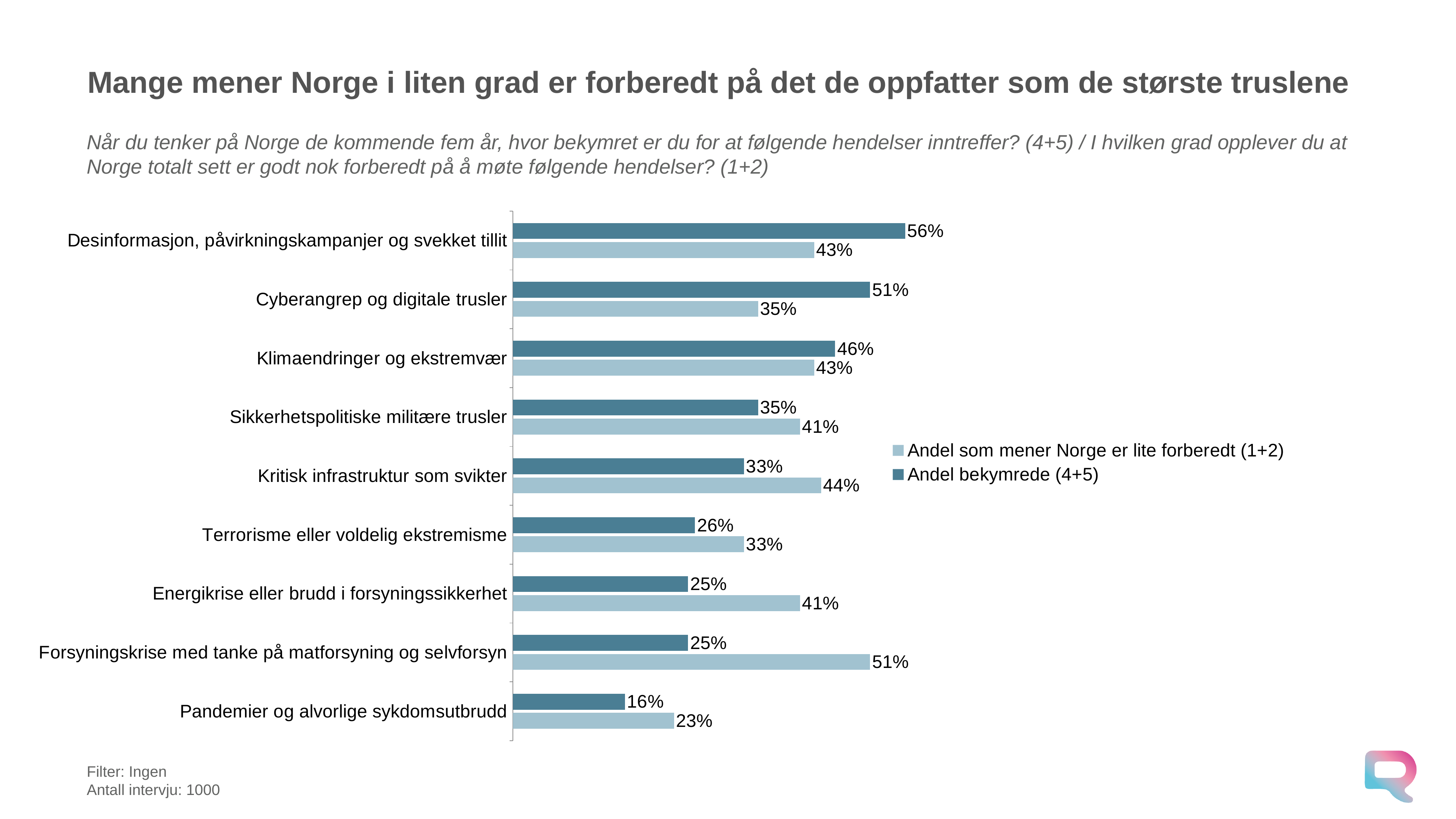
For 'Energikrise eller brudd i forsyningssikkerhet', which is larger: 'Andel bekymrede (4+5)' or 'Andel som mener Norge er lite forberedt (1+2)'? Andel som mener Norge er lite forberedt (1+2) How many series does the legend list? 2 Which series is shown in the darker blue colour? Andel bekymrede (4+5) What kind of chart is shown on the slide? Bar chart How many categories are shown in the chart? 9 What is the value of 'Andel som mener Norge er lite forberedt (1+2)' for 'Cyberangrep og digitale trusler'? 35% Which category has the highest value for 'Andel bekymrede (4+5)'? Desinformasjon, påvirkningskampanjer og svekket tillit What is the difference between 'Andel bekymrede (4+5)' and 'Andel som mener Norge er lite forberedt (1+2)' for 'Cyberangrep og digitale trusler'? 16 percentage points What is the value of 'Andel som mener Norge er lite forberedt (1+2)' for 'Forsyningskrise med tanke på matforsyning og selvforsyn'? 51% What is the value of 'Andel bekymrede (4+5)' for 'Pandemier og alvorlige sykdomsutbrudd'? 16% Which category has the lowest value for 'Andel som mener Norge er lite forberedt (1+2)'? Pandemier og alvorlige sykdomsutbrudd What is the value of 'Andel bekymrede (4+5)' for 'Desinformasjon, påvirkningskampanjer og svekket tillit'? 56%